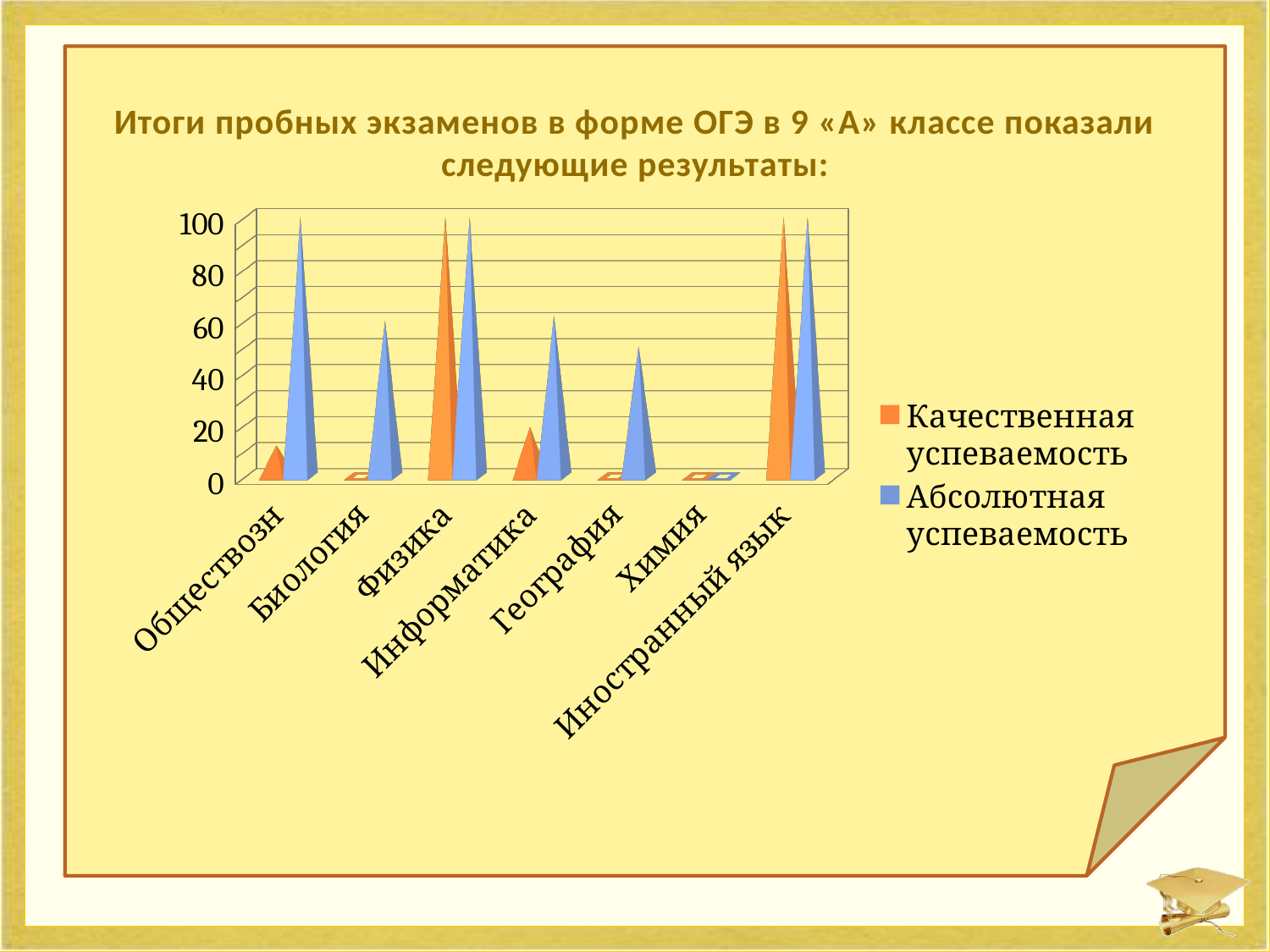
Is the value of Качественная успеваемость for Информатика greater or less than 40? less Is the value of Абсолютная успеваемость for География greater or less than 80? less What colour represents Качественная успеваемость in the chart? orange How many subjects (categories) are shown on the x axis of the chart? 7 Is the value of Качественная успеваемость for Иностранный язык greater or less than 60? greater Which subject has the lowest value of Абсолютная успеваемость? Химия What are the two series listed in the chart legend? Качественная успеваемость and Абсолютная успеваемость For Обществозн, which series has the larger value: Качественная успеваемость or Абсолютная успеваемость? Абсолютная успеваемость How many series does the chart legend list? 2 Which has the larger value of Качественная успеваемость: Физика or Информатика? Физика What kind of chart is shown on the slide? bar chart